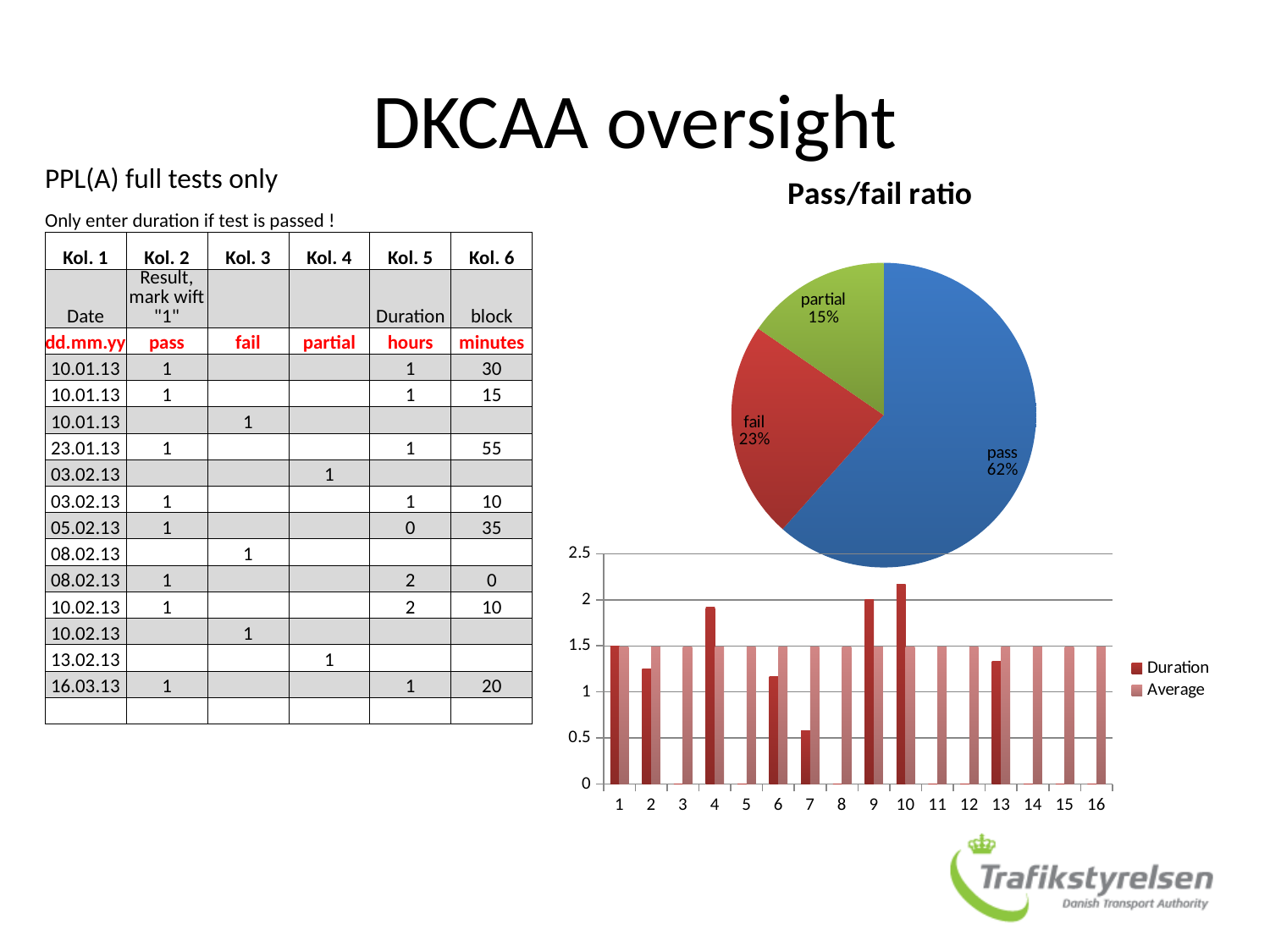
In the Pass/fail ratio pie chart, which slice is the smallest? partial In the Pass/fail ratio pie chart, what percentage is shown for fail? 23% In the Pass/fail ratio pie chart, which slice is the largest? pass In the bar chart at the bottom right, how many series does the legend list? 2 In the bar chart at the bottom right, is the Duration value for category 10 greater or less than 2? greater In the Pass/fail ratio pie chart, how many percentage points larger is pass than fail? 39% In the Pass/fail ratio pie chart, what percentage is shown for partial? 15% In the bar chart at the bottom right, is the Duration value for category 7 greater or less than 1? less In the bar chart at the bottom right, how many categories are shown on the x axis? 16 In the Pass/fail ratio pie chart, how many slices are there? 3 In the bar chart at the bottom right, which is larger: the Duration value for category 10 or for category 2? category 10 In the Pass/fail ratio pie chart, what percentage is shown for pass? 62%